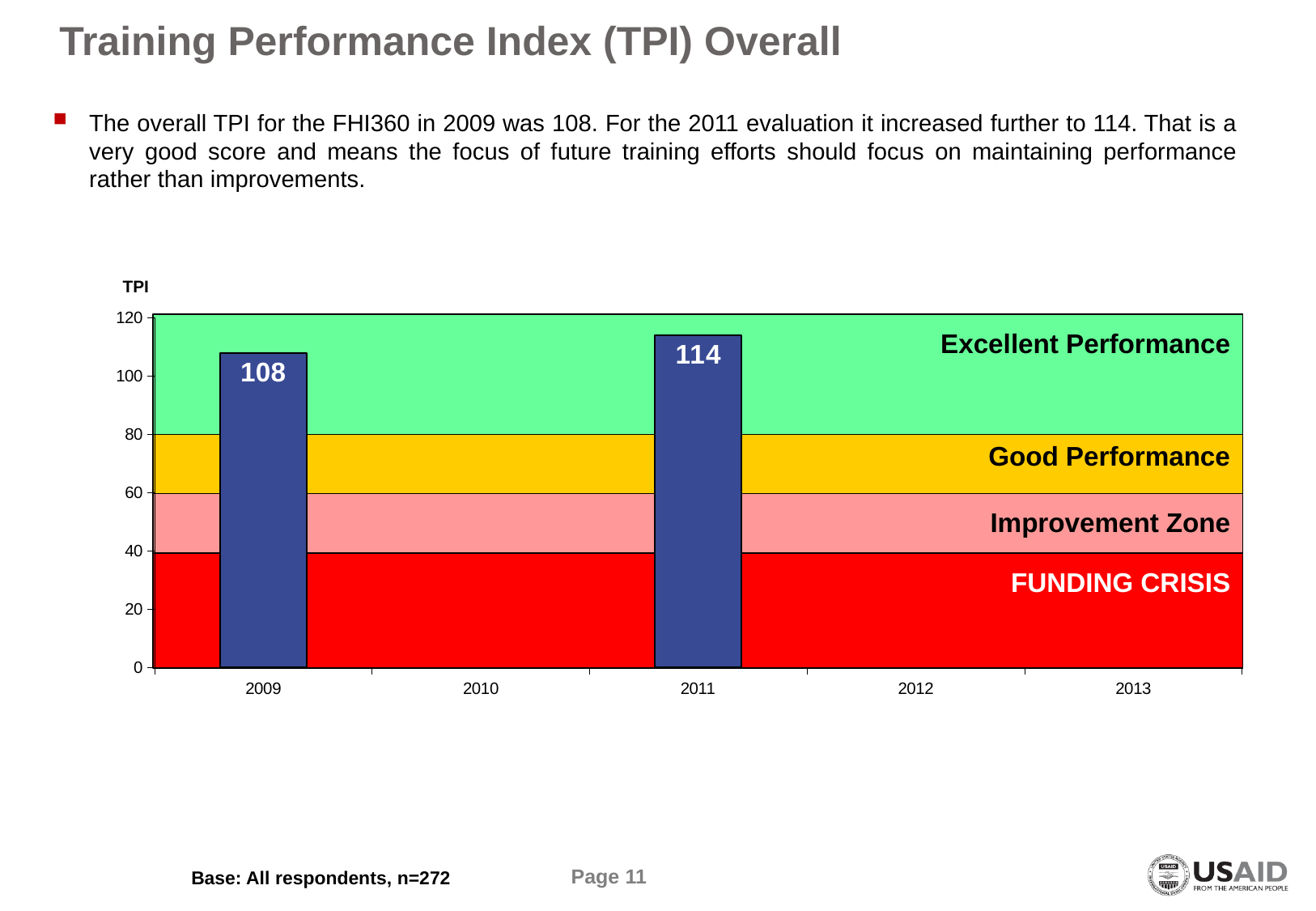
How many years are labelled on the x axis of the chart? 5 What kind of chart is shown on the slide? bar chart What is the TPI value for 2009? 108 Is the TPI value for 2009 greater or less than 100? greater Does the TPI rise or fall from 2009 to 2011? rise What is the TPI value for 2011? 114 By how much did the TPI increase from 2009 to 2011? 6 Which performance zone is shaded green on the chart? Excellent Performance Is the TPI value for 2011 greater or less than 120? less How many bars are plotted on the chart? 2 What is the label of the y axis on the chart? TPI Which year has the higher TPI, 2009 or 2011? 2011